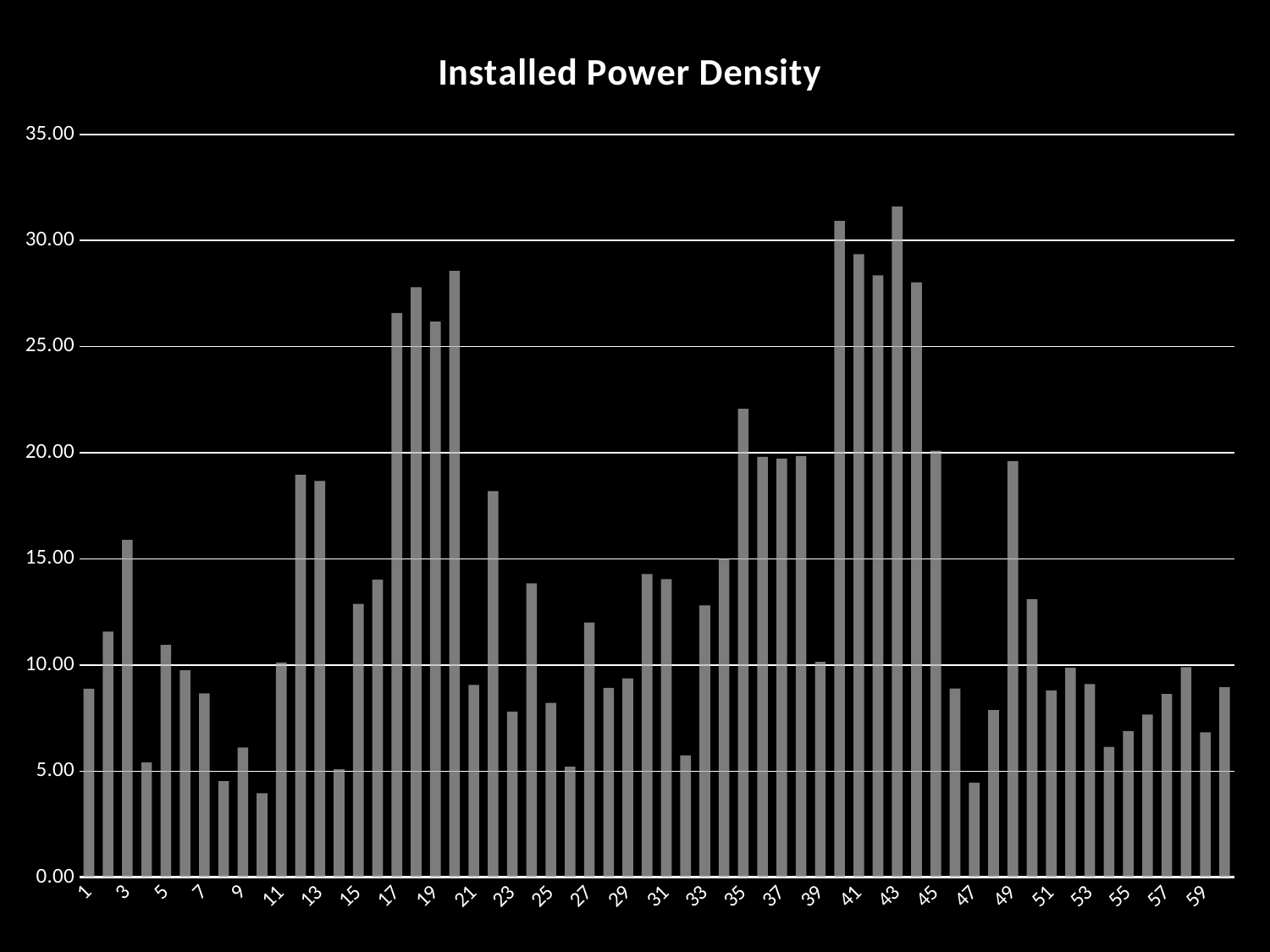
Is the value for category 35 greater or less than 20.00? greater Is the value for category 13 greater or less than 15.00? greater Which is larger, the value for category 3 or the value for category 5? 3 Is the value for category 17 greater or less than 25.00? greater What is the title of the chart? Installed Power Density Which category has the highest value in the chart? 43 How many bars are plotted in the chart? 60 What kind of chart is shown on the slide? bar chart Which is larger, the value for category 20 or the value for category 17? 20